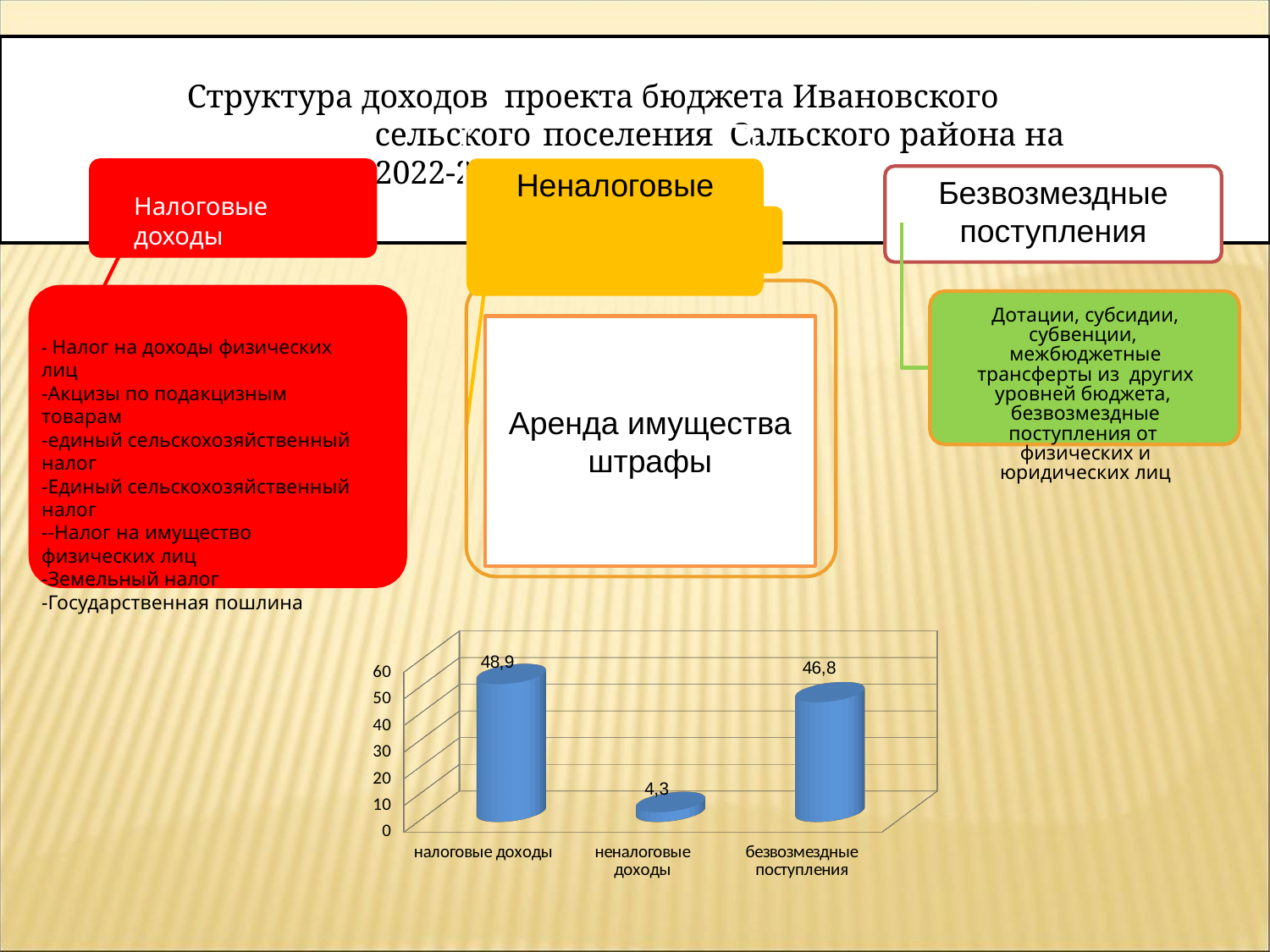
What is the difference between the values for налоговые доходы and безвозмездные поступления? 2,1 Which category has the highest value in the chart? налоговые доходы What is the highest value shown on the vertical axis of the chart? 60 Which category has the lowest value in the chart? неналоговые доходы How many categories are shown in the chart? 3 What is the value for безвозмездные поступления in the chart? 46,8 What kind of chart is shown on the slide? bar chart What is the value for неналоговые доходы in the chart? 4,3 Which is larger: the value for налоговые доходы or the value for безвозмездные поступления? налоговые доходы What is the value for налоговые доходы in the chart? 48,9 Is the value for безвозмездные поступления greater or less than 40? greater What is the difference between the values for налоговые доходы and неналоговые доходы? 44,6